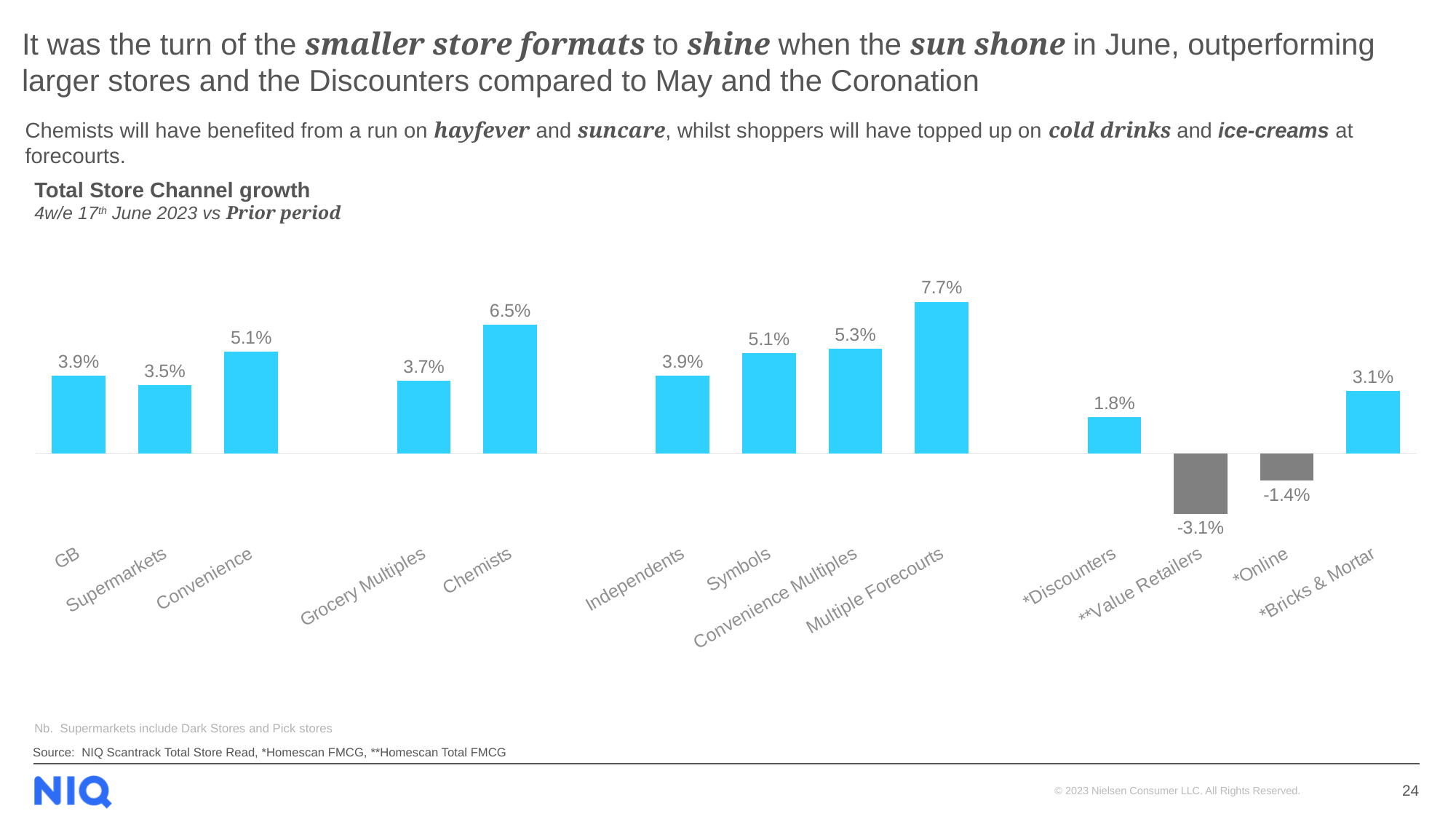
How many categories are shown on the chart? 13 What kind of chart is shown on the slide? Bar chart What is the growth value for *Online? -1.4% How many categories have a negative growth value? 2 Which category has the lowest growth value? **Value Retailers Which has the larger growth value, Convenience or Supermarkets? Convenience What is the difference between the growth values for Chemists and Grocery Multiples? 2.8% What is the growth value for **Value Retailers? -3.1% What is the title of the chart? Total Store Channel growth What is the growth value for Chemists? 6.5% Which category has the highest growth value? Multiple Forecourts What is the growth value for Multiple Forecourts? 7.7%